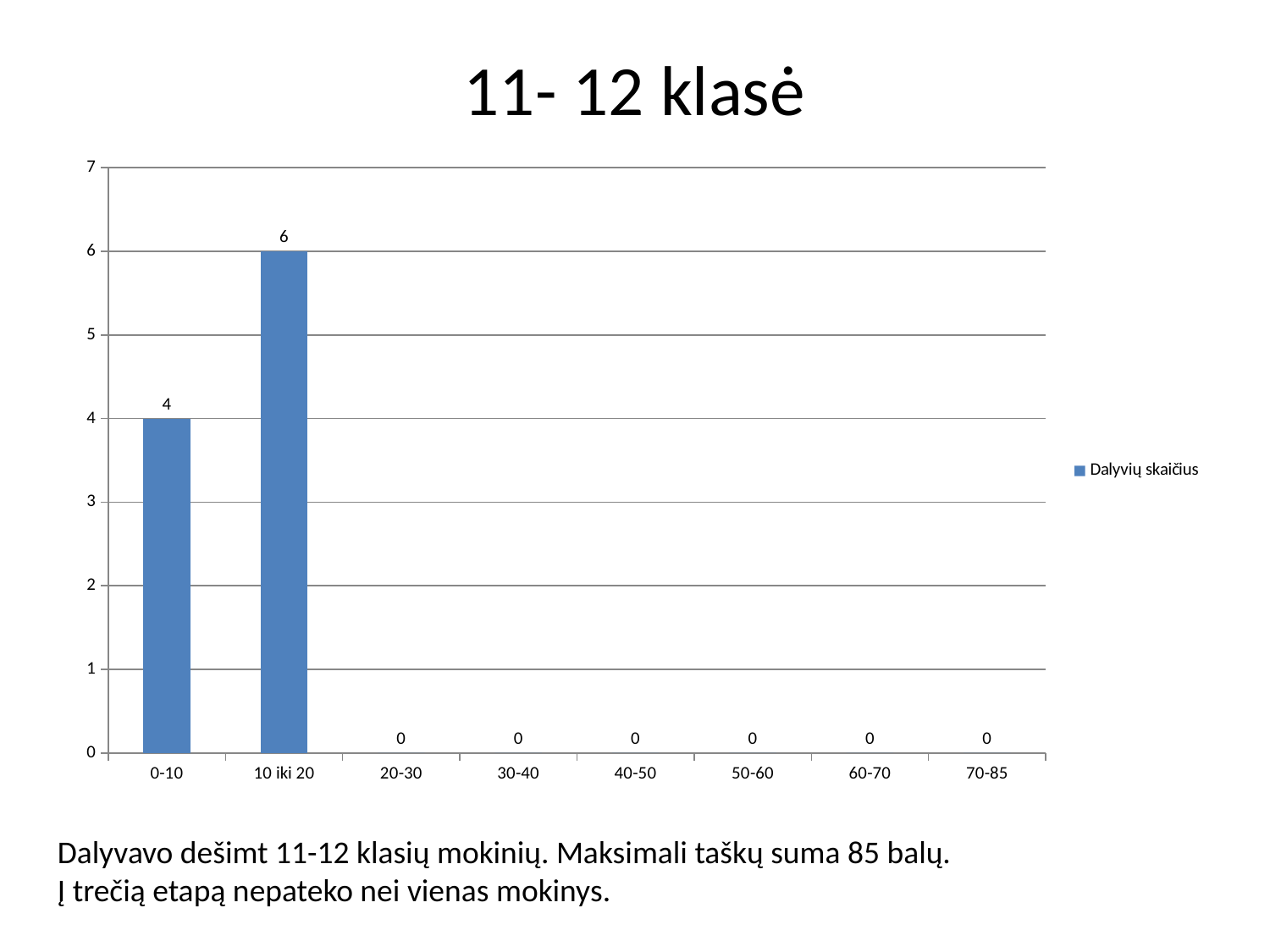
Which is larger, the value for 0-10 or the value for 10 iki 20? 10 iki 20 How many categories are shown on the x axis? 8 What is the name of the series in the legend? Dalyvių skaičius Which category has the highest value? 10 iki 20 What is the value for the 40-50 category? 0 What is the value for the 0-10 category? 4 What is the value for the 10 iki 20 category? 6 How many series does the legend list? 1 What is the difference between the values for 10 iki 20 and 0-10? 2 Is the value for 10 iki 20 greater or less than 5? greater What kind of chart is shown on the slide? bar chart What is the title of the slide? 11- 12 klasė